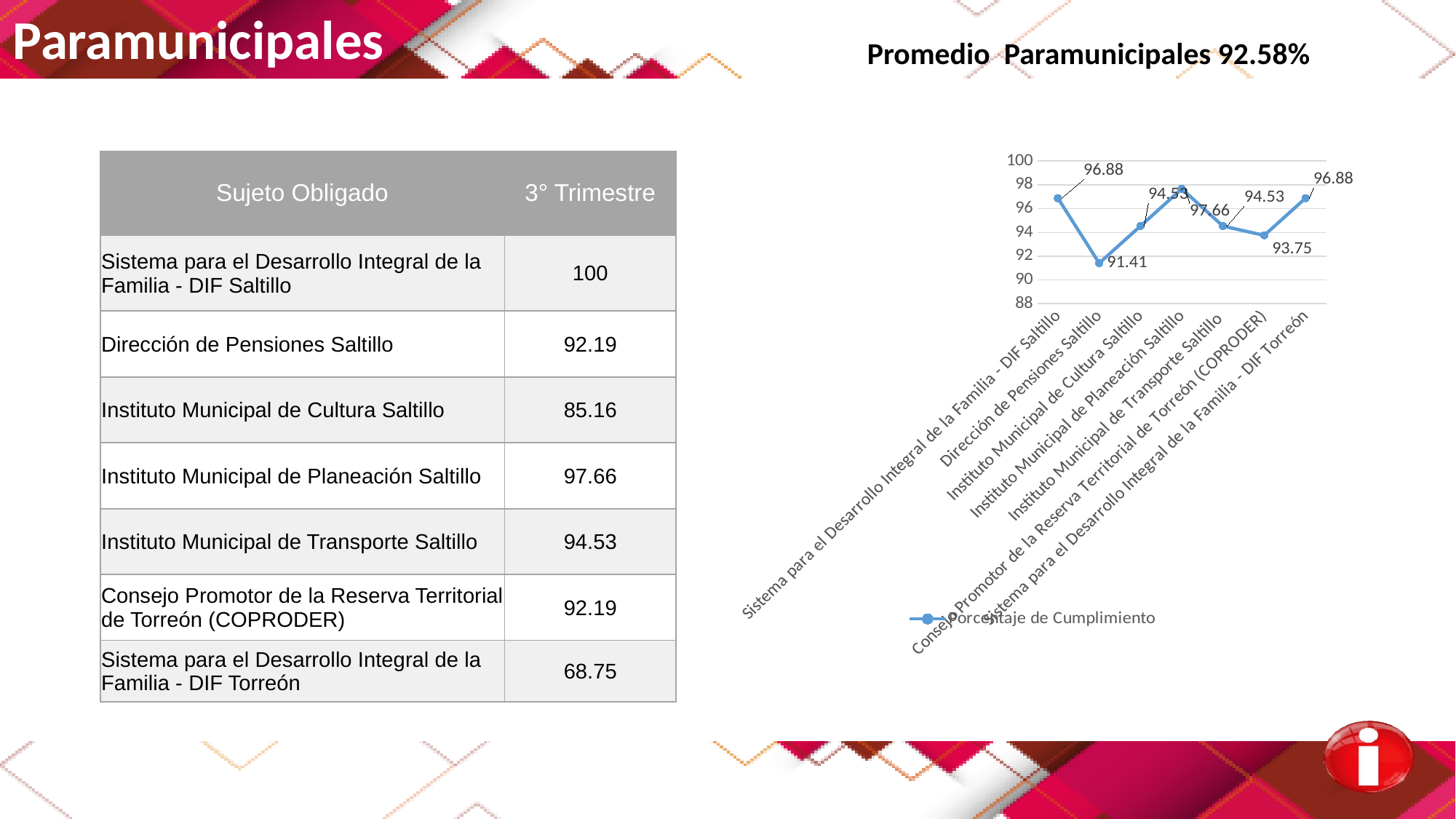
What kind of chart is shown on the slide? line chart In the chart, what is the difference between the values for Instituto Municipal de Planeación Saltillo and Dirección de Pensiones Saltillo? 6.25 In the chart, what value is labelled for Consejo Promotor de la Reserva Territorial de Torreón (COPRODER)? 93.75 Which category has the highest value in the chart? Instituto Municipal de Planeación Saltillo How many series does the chart legend list? 1 In the chart, does the value rise or fall from Sistema para el Desarrollo Integral de la Familia - DIF Saltillo to Dirección de Pensiones Saltillo? fall Which category has the lowest value in the chart? Dirección de Pensiones Saltillo In the chart, what value is labelled for Instituto Municipal de Planeación Saltillo? 97.66 In the chart, which is larger: the value for Dirección de Pensiones Saltillo or the value for Consejo Promotor de la Reserva Territorial de Torreón (COPRODER)? Consejo Promotor de la Reserva Territorial de Torreón (COPRODER) In the chart, what value is labelled for Dirección de Pensiones Saltillo? 91.41 How many data points are plotted on the line chart? 7 What is the name of the series shown in the chart legend? Porcentaje de Cumplimiento